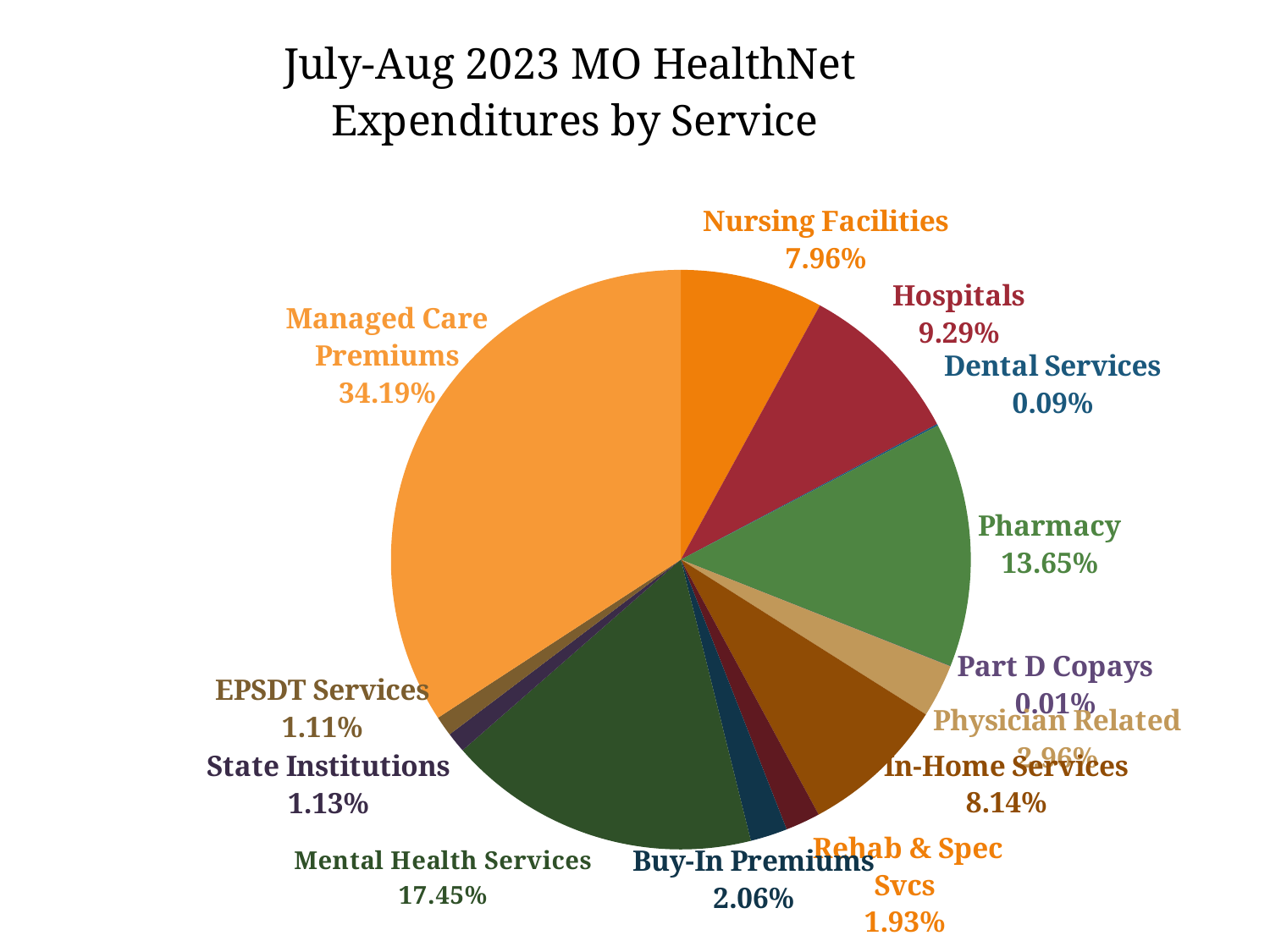
How many service categories are shown in the pie chart? 13 What is the difference in percentage points between Managed Care Premiums and Mental Health Services? 16.74% Which service category has the smallest share of expenditures? Part D Copays What is the title of the chart? July-Aug 2023 MO HealthNet Expenditures by Service Which has a larger share of expenditures, Mental Health Services or Pharmacy? Mental Health Services What percentage of expenditures is for Mental Health Services? 17.45% Which service category has the largest share of expenditures? Managed Care Premiums What is the difference in percentage points between Hospitals and Nursing Facilities? 1.33% What percentage of expenditures is for Pharmacy? 13.65% What percentage of expenditures is for Managed Care Premiums? 34.19% What kind of chart is shown on the slide? pie chart What percentage of expenditures is for In-Home Services? 8.14%